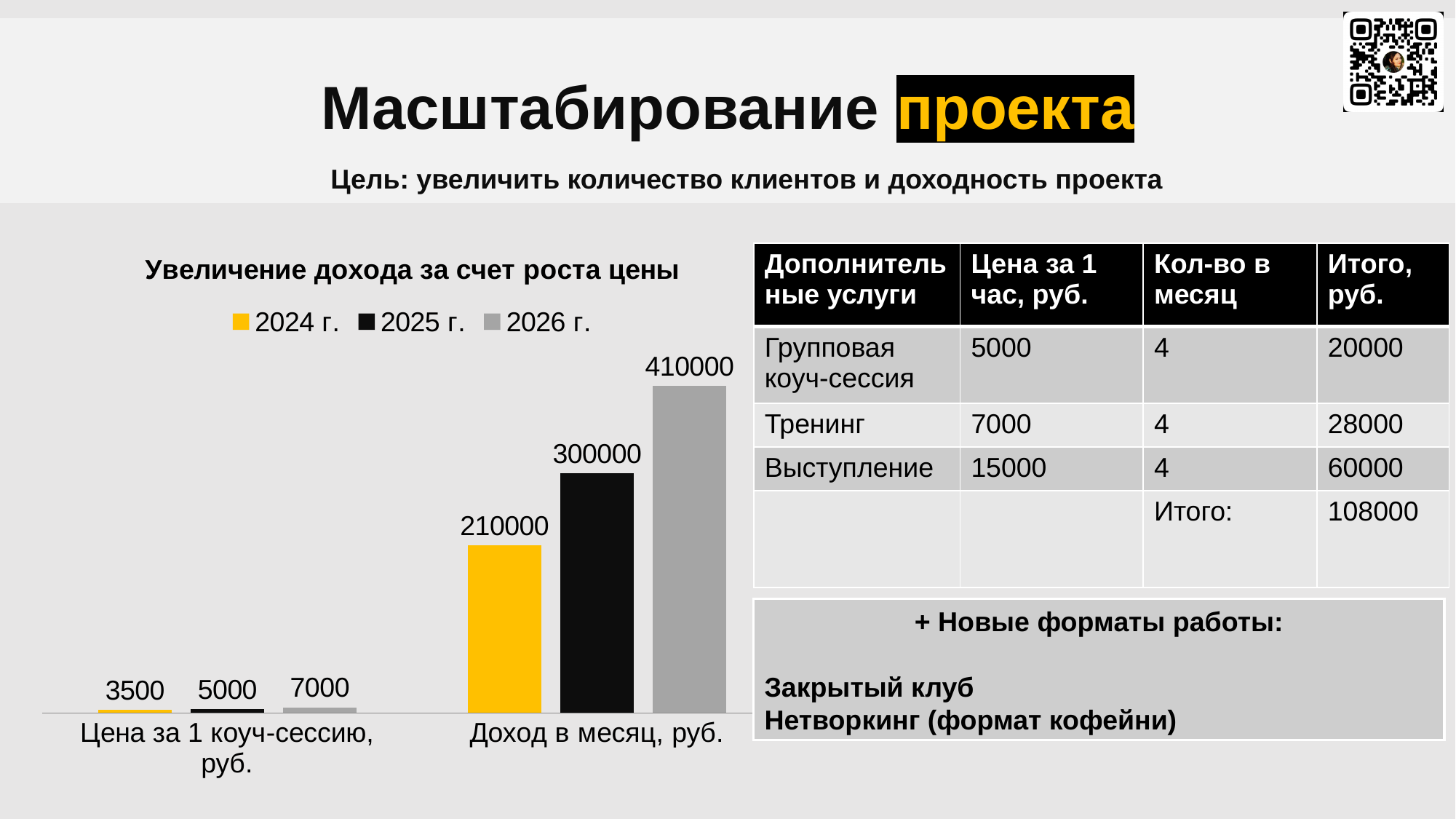
Which is larger: the 2025 г. value or the 2026 г. value in the category 'Цена за 1 коуч-сессию, руб.'? 2026 г. Which year has the highest value in the category 'Доход в месяц, руб.'? 2026 г. Which year has the lowest value in the category 'Цена за 1 коуч-сессию, руб.'? 2024 г. What kind of chart is shown on the slide? Bar chart What is the value for 2026 г. in the category 'Доход в месяц, руб.'? 410000 What is the title of the chart? Увеличение дохода за счет роста цены How many series does the chart legend list? 3 What is the difference between the 2025 г. and 2024 г. values in the category 'Цена за 1 коуч-сессию, руб.'? 1500 What is the difference between the 2026 г. and 2024 г. values in the category 'Доход в месяц, руб.'? 200000 What is the value for 2024 г. in the category 'Цена за 1 коуч-сессию, руб.'? 3500 What is the value for 2025 г. in the category 'Доход в месяц, руб.'? 300000 How many categories are shown on the x axis of the chart? 2